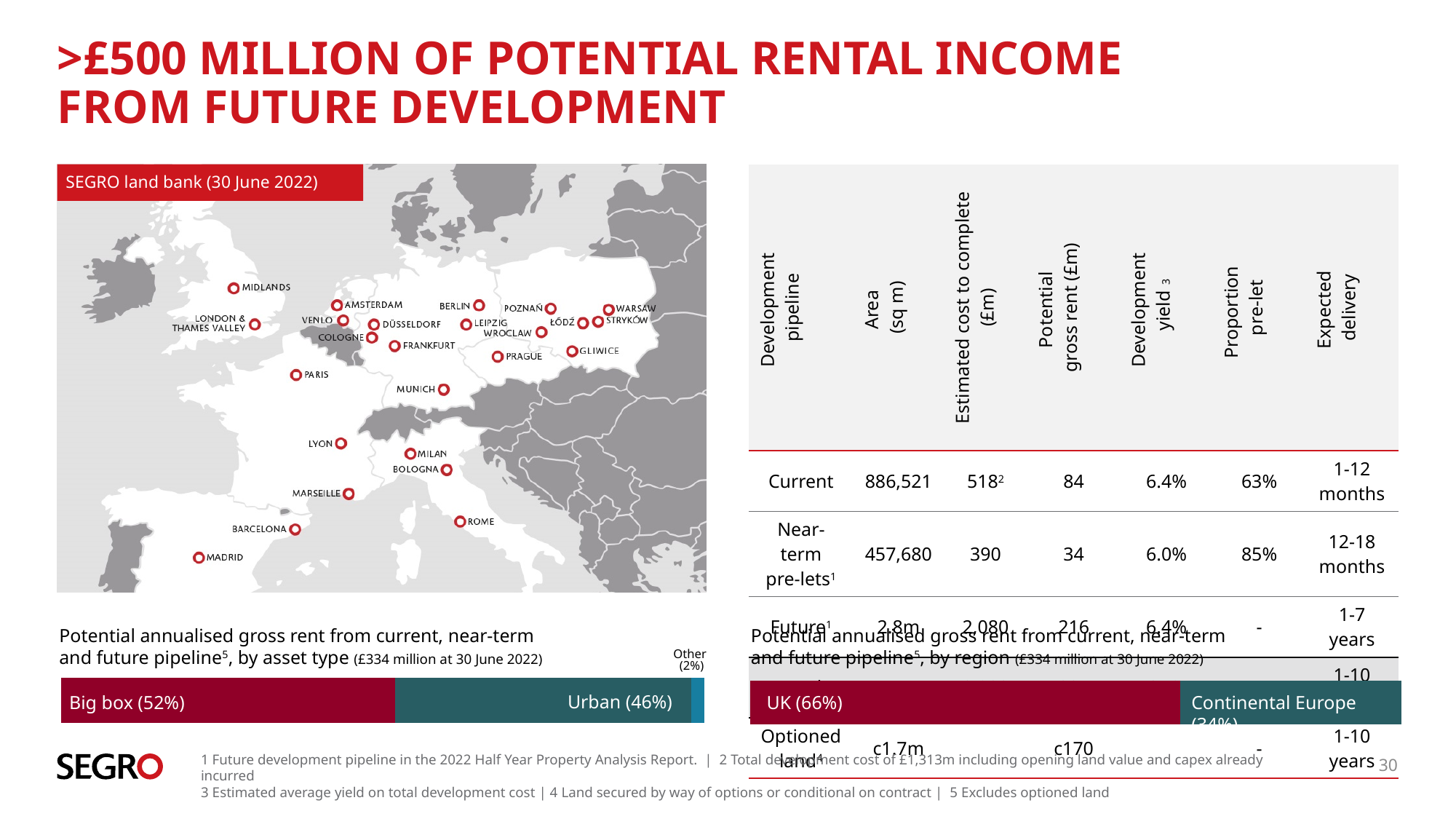
What total amount at 30 June 2022 is stated in the subtitle of the 'by region' chart? £334 million In the 'by asset type' chart, what share does Big box account for? 52% In the 'by region' chart, what share does the UK account for? 66% In the 'by region' chart, how many region segments are shown? 2 In the 'by asset type' chart, what share does Other account for? 2% In the 'by region' chart, which region has the larger share, UK or Continental Europe? UK In the 'by asset type' chart, which asset type has the largest share? Big box In the 'by asset type' chart, which asset type has the smallest share? Other In the 'by asset type' chart, what share does Urban account for? 46% In the 'by asset type' chart, what is the difference in percentage points between Big box and Urban? 6 percentage points In the 'by asset type' chart, how many asset type segments are shown? 3 What kind of chart is the 'by asset type' chart? Stacked bar chart